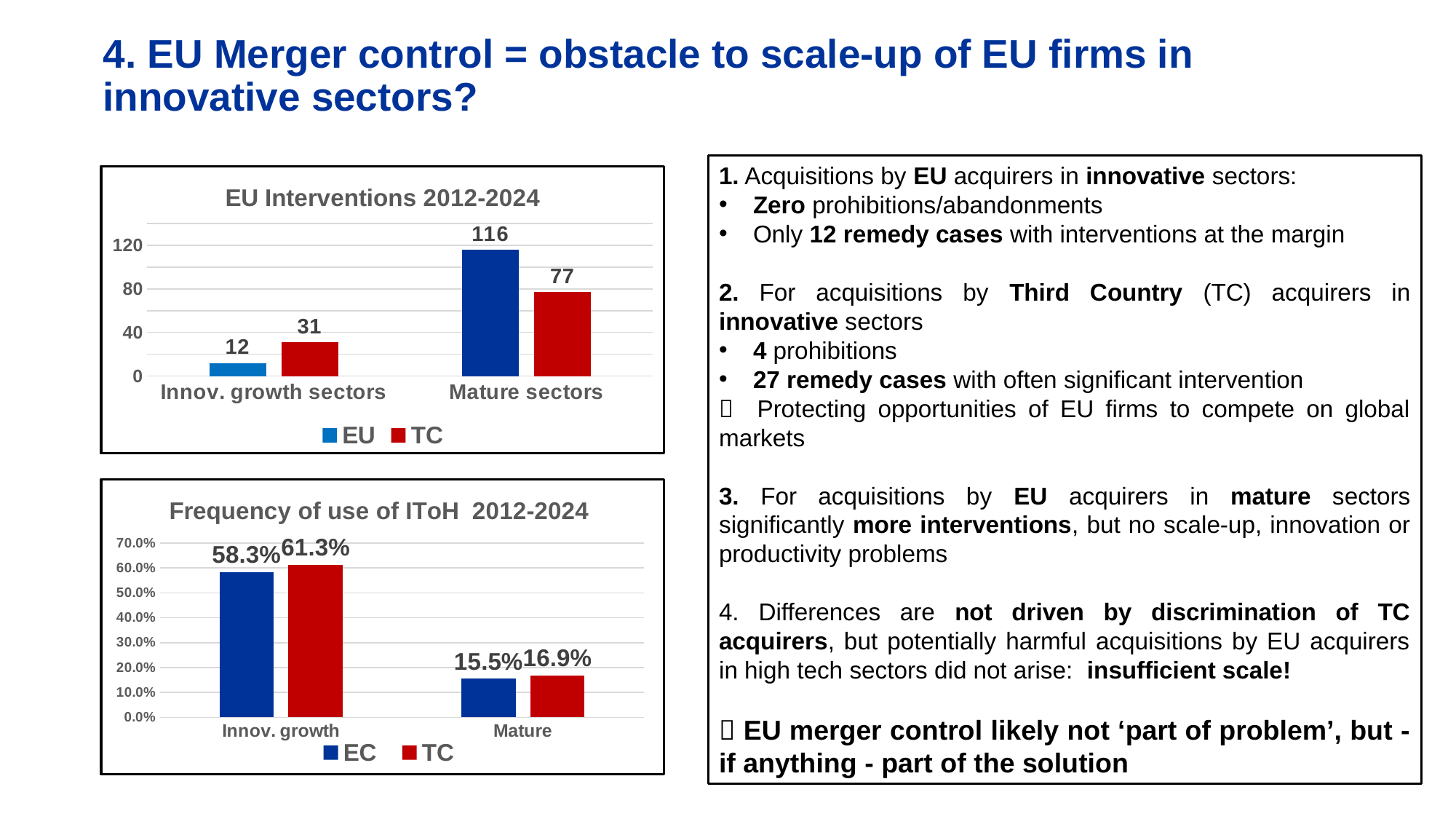
In the 'Frequency of use of IToH 2012-2024' chart, how many categories are shown on the x axis? 2 In the 'EU Interventions 2012-2024' chart, what is the value for TC in Mature sectors? 77 In the 'Frequency of use of IToH 2012-2024' chart, what is the value for EC in Innov. growth? 58.3% In the 'Frequency of use of IToH 2012-2024' chart, what is the value for TC in Mature? 16.9% What kind of chart is 'Frequency of use of IToH 2012-2024'? Bar chart In the 'EU Interventions 2012-2024' chart, which is larger in Innov. growth sectors, EU or TC? TC In the 'EU Interventions 2012-2024' chart, what is the difference between the EU and TC values in Mature sectors? 39 In the 'Frequency of use of IToH 2012-2024' chart, what is the difference between the TC and EC values in Innov. growth? 3.0% In the 'EU Interventions 2012-2024' chart, which bar has the highest value? EU, Mature sectors In the 'Frequency of use of IToH 2012-2024' chart, which bar has the lowest value? EC, Mature In the 'EU Interventions 2012-2024' chart, what is the value for EU in Innov. growth sectors? 12 In the 'EU Interventions 2012-2024' chart, how many series does the legend list? 2